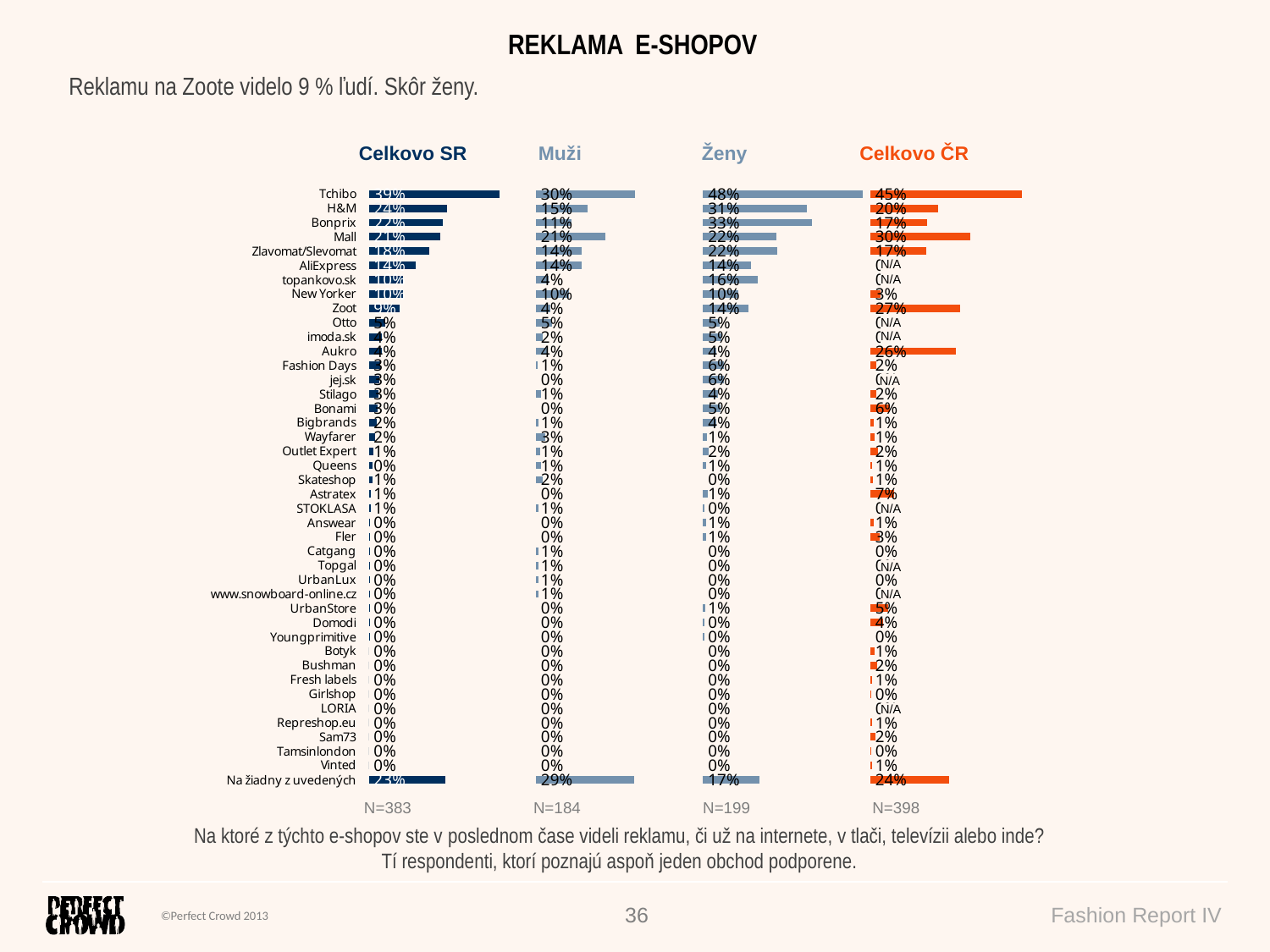
In the Celkovo ČR chart, what is the value for Mall? 30% In the Muži chart, what is the value for 'Na žiadny z uvedených'? 29% In the Celkovo ČR chart, what is the difference between Tchibo (45%) and Mall (30%)? 15 percentage points In the Ženy chart, which e-shop has the highest value? Tchibo In the Muži chart, what is the value for Tchibo? 30% In the Celkovo ČR chart, which e-shop has the highest value? Tchibo What is the sample size (N) shown under the Ženy chart? N=199 What kind of chart is used on this slide? Bar chart What is the difference between the Tchibo value in the Ženy chart (48%) and in the Muži chart (30%)? 18 percentage points In the Celkovo ČR chart, what is the value for Zoot? 27% In the Ženy chart, what is the value for Bonprix? 33% Is the value for Zoot larger in the Muži chart or in the Ženy chart? Ženy